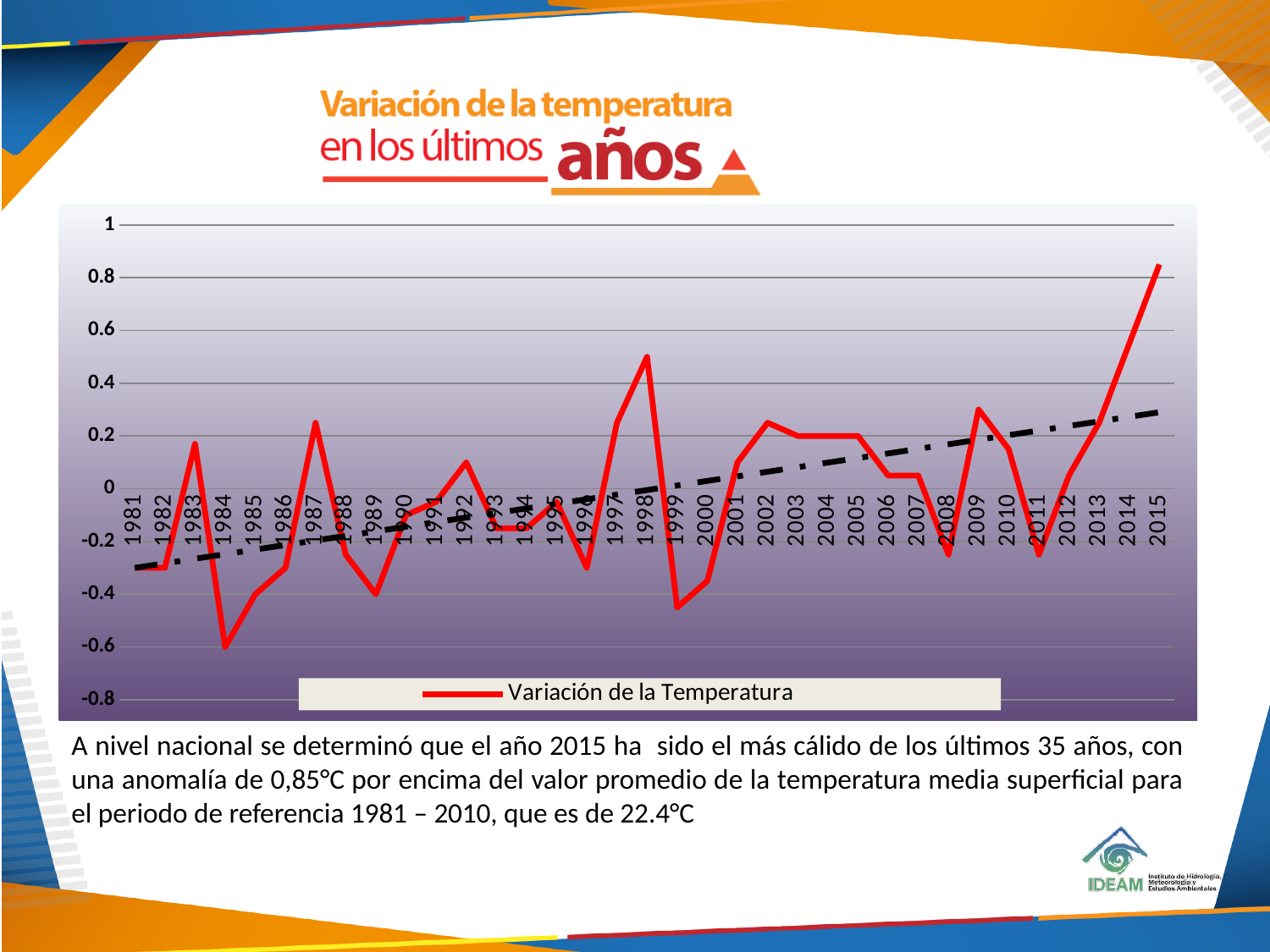
Is the value for 1998 greater or less than 0.4? greater Does the dashed trend line rise or fall from 1981 to 2015? rise How many years are plotted along the x axis of the chart? 35 How many series does the chart legend list? 1 Which year has the larger temperature variation, 1998 or 2009? 1998 Which year has the lowest temperature variation in the chart? 1984 What is the name of the series shown in the legend? Variación de la Temperatura Is the value for 1989 greater or less than -0.2? less Is the value for 2015 greater or less than 0.6? greater What kind of chart is shown on the slide? line chart Which year has the highest temperature variation in the chart? 2015